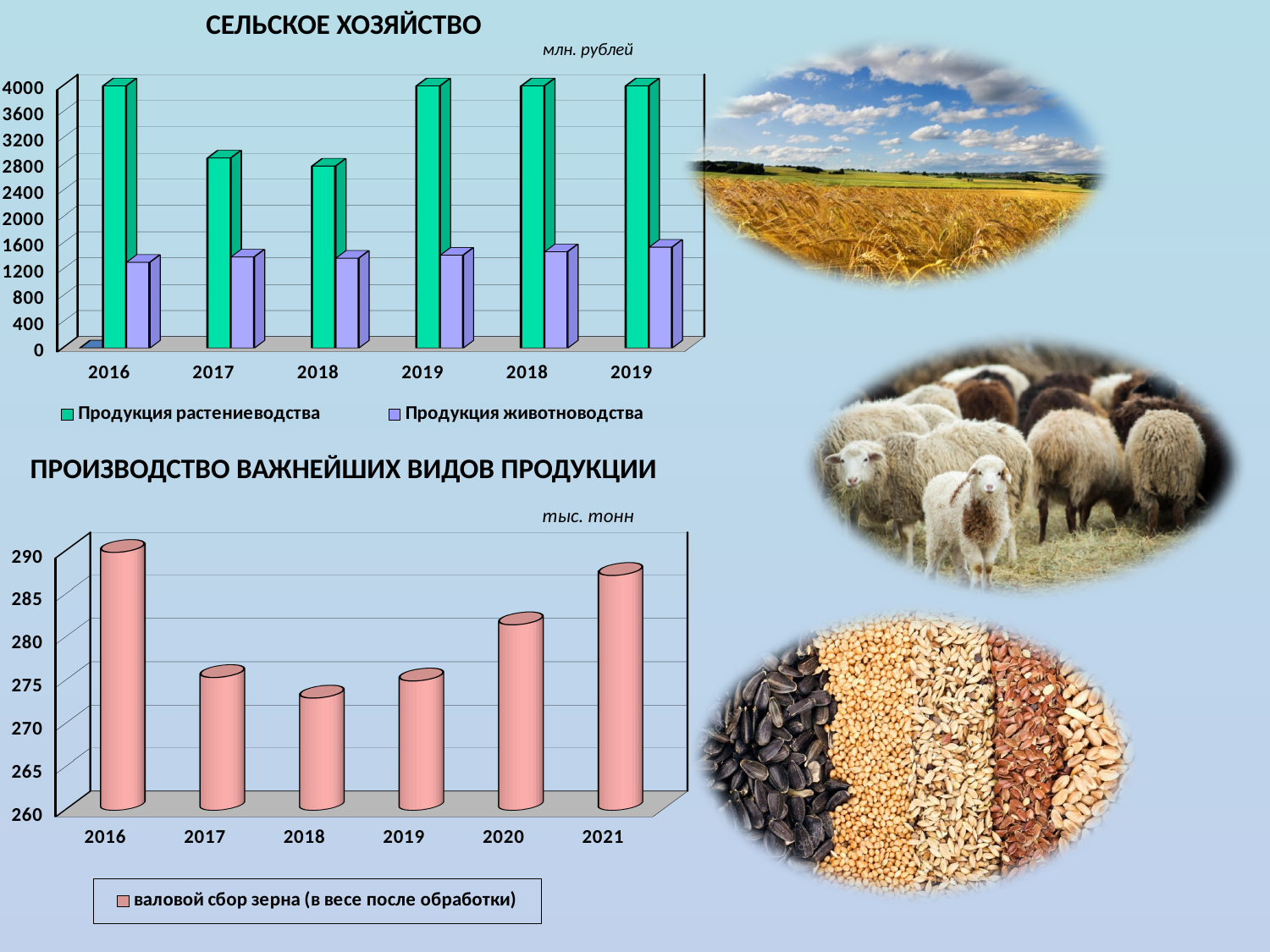
What unit is shown above the top chart 'СЕЛЬСКОЕ ХОЗЯЙСТВО'? млн. рублей In the bottom chart 'ПРОИЗВОДСТВО ВАЖНЕЙШИХ ВИДОВ ПРОДУКЦИИ', do the values rise or fall from 2018 to 2021? rise How many series does the legend of the top chart 'СЕЛЬСКОЕ ХОЗЯЙСТВО' list? 2 In the bottom chart 'ПРОИЗВОДСТВО ВАЖНЕЙШИХ ВИДОВ ПРОДУКЦИИ', which year has the lowest value? 2018 In the top chart 'СЕЛЬСКОЕ ХОЗЯЙСТВО', is the value for 'Продукция животноводства' in 2016 greater or less than 1600? less In the top chart 'СЕЛЬСКОЕ ХОЗЯЙСТВО', which series has the larger value in 2016, 'Продукция растениеводства' or 'Продукция животноводства'? Продукция растениеводства What is the legend entry of the bottom chart 'ПРОИЗВОДСТВО ВАЖНЕЙШИХ ВИДОВ ПРОДУКЦИИ'? валовой сбор зерна (в весе после обработки) How many categories are shown on the x axis of the bottom chart 'ПРОИЗВОДСТВО ВАЖНЕЙШИХ ВИДОВ ПРОДУКЦИИ'? 6 What kind of chart is the top chart titled 'СЕЛЬСКОЕ ХОЗЯЙСТВО'? bar chart In the bottom chart 'ПРОИЗВОДСТВО ВАЖНЕЙШИХ ВИДОВ ПРОДУКЦИИ', is the value for 2018 greater or less than 275? less In the bottom chart 'ПРОИЗВОДСТВО ВАЖНЕЙШИХ ВИДОВ ПРОДУКЦИИ', is the value for 2016 greater or less than 285? greater